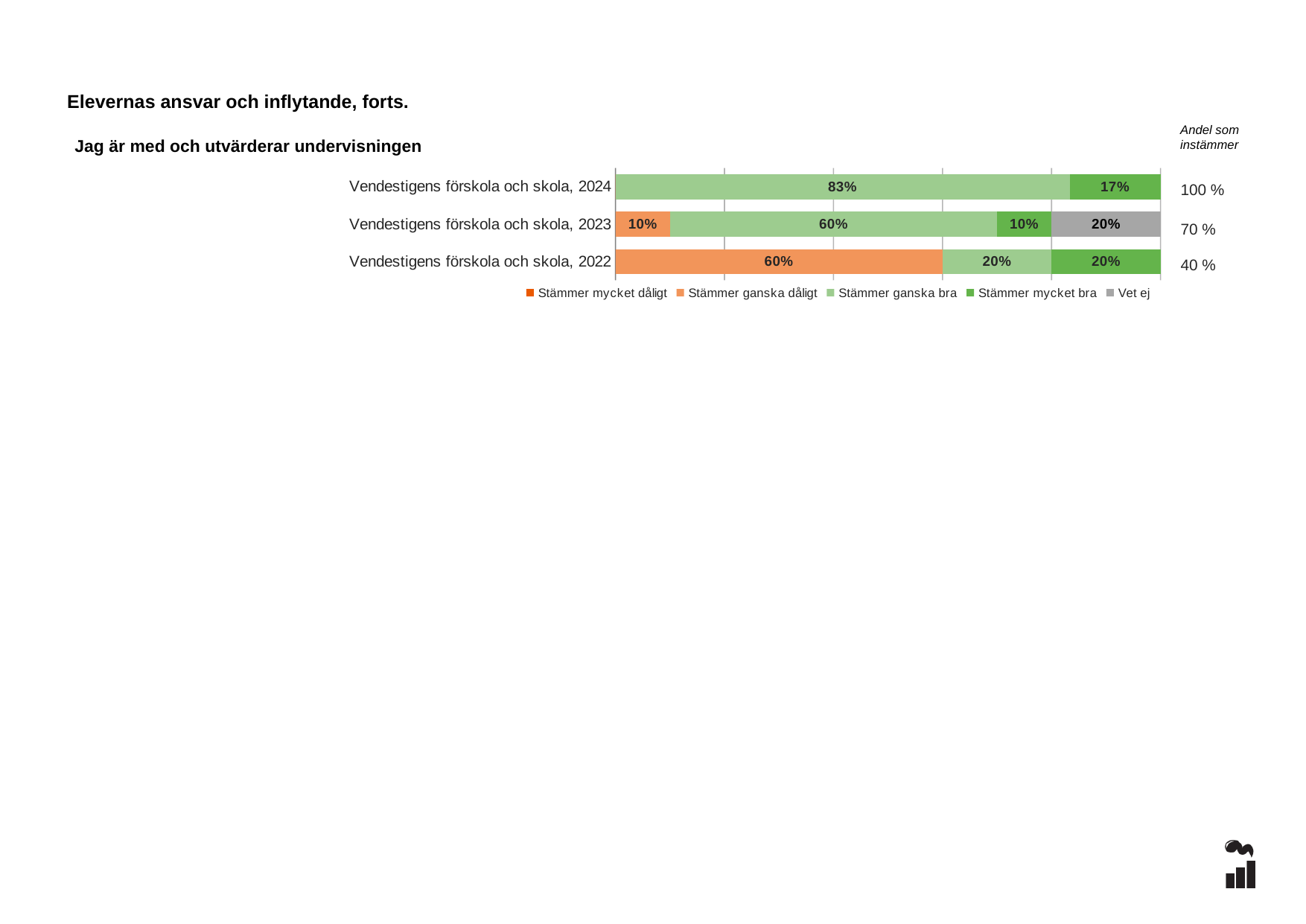
What is the value for "Vet ej" for Vendestigens förskola och skola, 2023? 20% What is the title of the chart? Jag är med och utvärderar undervisningen How many series does the legend list? 5 What is the value for "Stämmer mycket bra" for Vendestigens förskola och skola, 2024? 17% What is the difference between the "Stämmer ganska bra" values for 2024 and 2023? 23% What is the value for "Stämmer ganska dåligt" for Vendestigens förskola och skola, 2023? 10% How many bars (categories) are shown in the chart? 3 Which year has the highest "Andel som instämmer" value? 2024 What is the value for "Stämmer ganska dåligt" for Vendestigens förskola och skola, 2022? 60% What is the value for "Stämmer ganska bra" for Vendestigens förskola och skola, 2024? 83% Which is larger: the "Stämmer ganska dåligt" value for 2022 or for 2023? 2022 What kind of chart is shown on the slide? Stacked bar chart